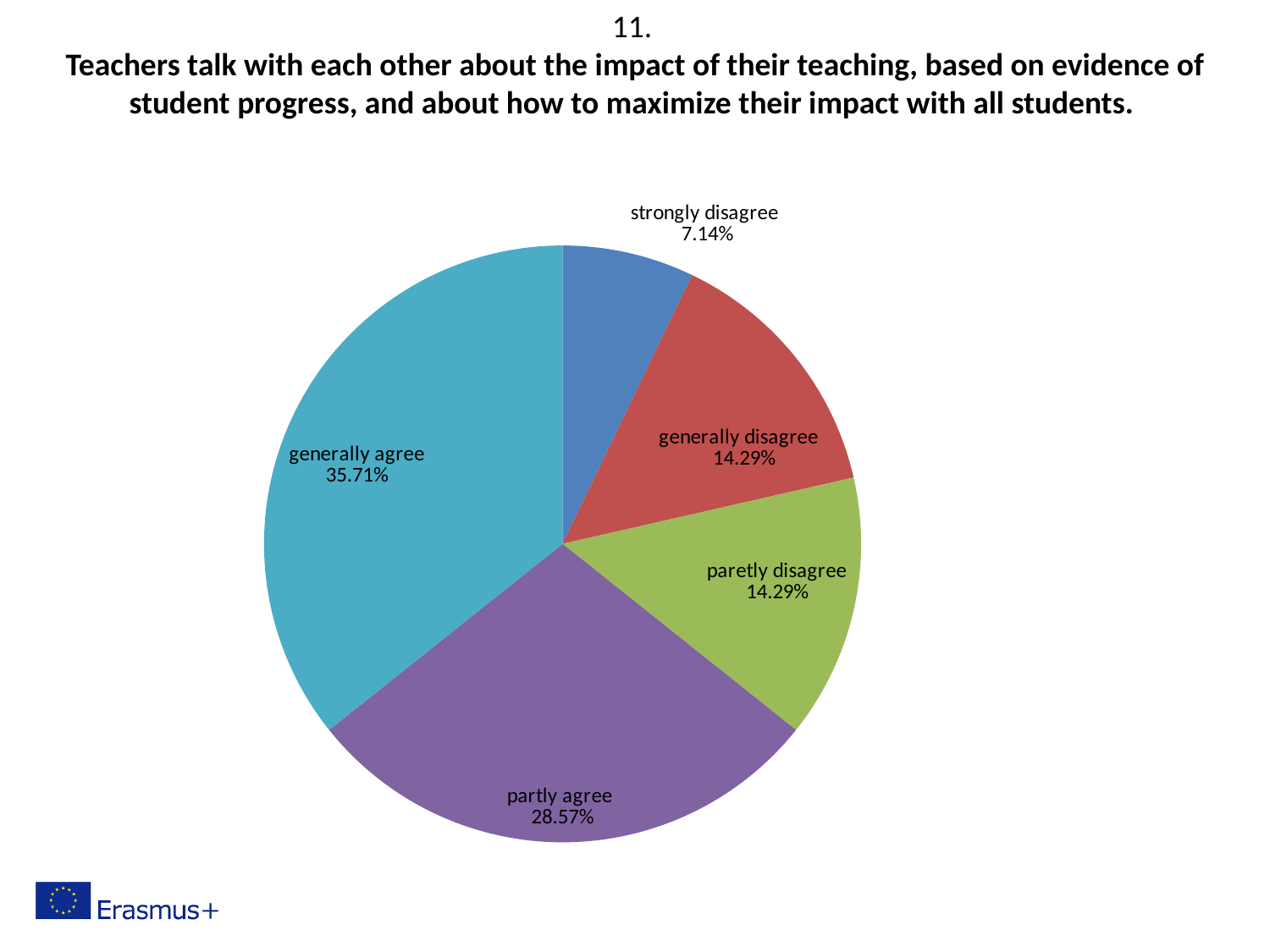
What share of the pie is labelled "partly agree"? 28.57% How many slices does the pie chart have? 5 Which slice of the pie is the smallest? strongly disagree What share of the pie is labelled "generally disagree"? 14.29% Which is larger, the "partly agree" slice or the "paretly disagree" slice? partly agree What share of the pie is labelled "strongly disagree"? 7.14% What kind of chart is shown on the slide? pie chart What colour is the "generally agree" slice? teal/light blue Which slice of the pie is the largest? generally agree What is the combined share of "generally disagree" and "paretly disagree"? 28.58% What is the difference between the "generally agree" and "partly agree" shares? 7.14% What share of the pie is labelled "generally agree"? 35.71%